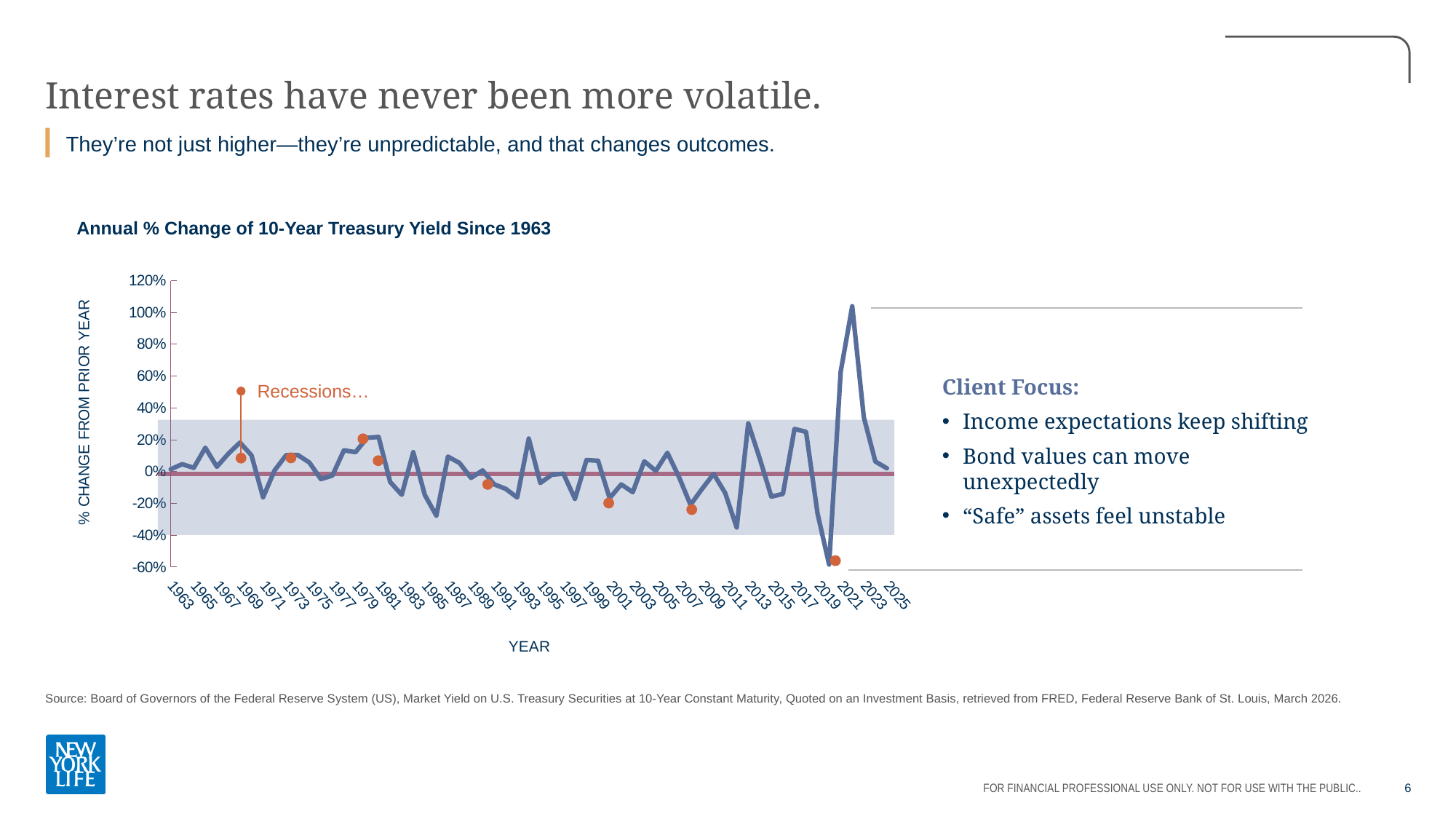
What type of chart is shown on the slide? Line chart Is the lowest point on the line greater or less than -40%? less Which year has the larger value, 2021 or 1981? 2021 Is the value for 2021 greater or less than 80%? less What is the title of the chart? Annual % Change of 10-Year Treasury Yield Since 1963 What is the first year shown on the horizontal axis? 1963 What is the last year shown on the horizontal axis? 2025 Is the value for 2013 greater or less than 20%? greater What is the label of the vertical axis of the chart? % CHANGE FROM PRIOR YEAR What is the highest value shown on the vertical axis? 120%